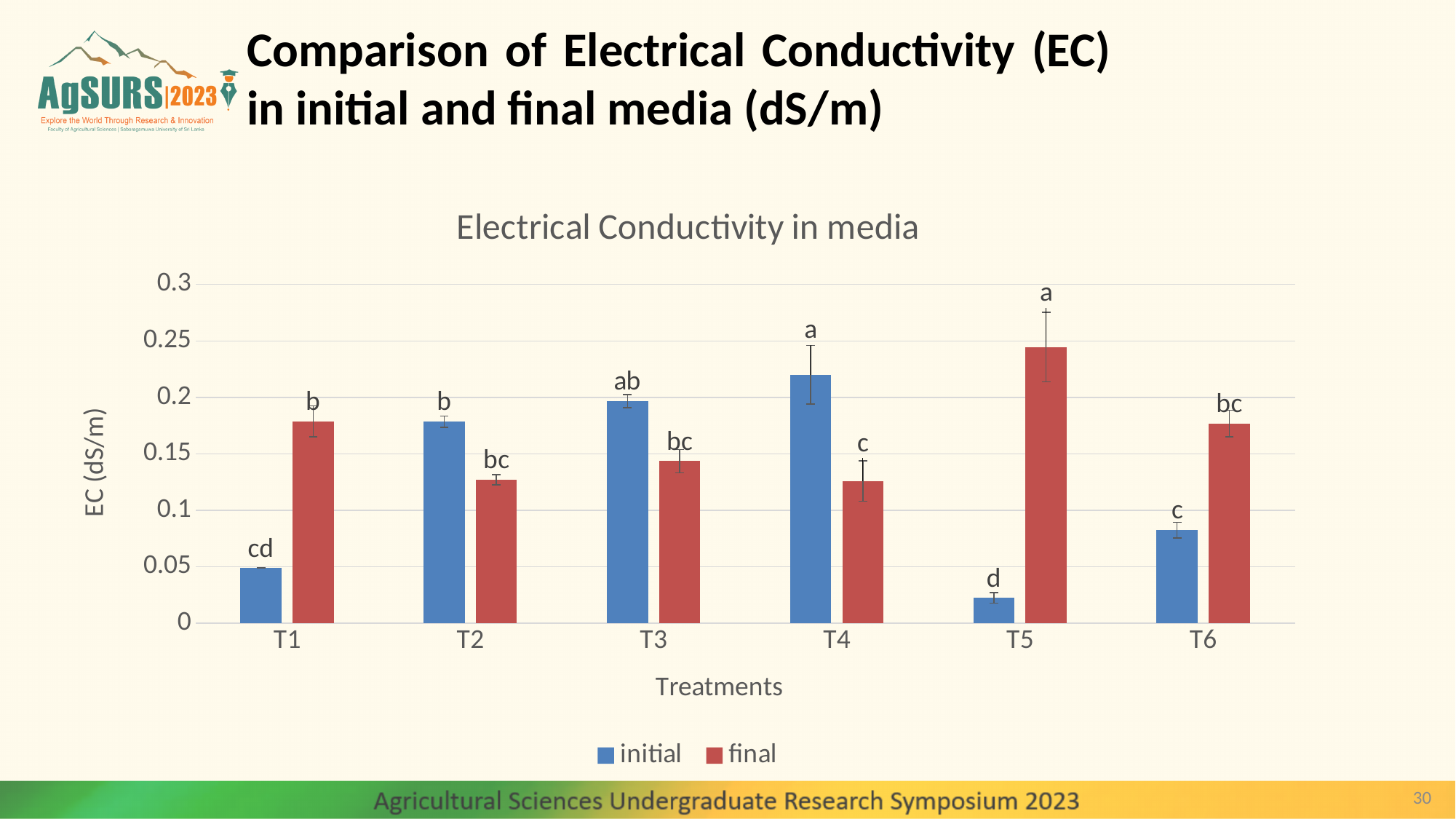
For T1, which is larger: the initial or the final EC value? final For T2, which is larger: the initial or the final EC value? initial What is the label on the y axis of the chart? EC (dS/m) How many treatments are shown on the x axis? 6 How many series does the legend list? 2 Which treatment has the highest final EC value? T5 Is the final EC value for T5 greater or less than 0.2? greater What kind of chart is shown on the slide? bar chart Which treatment has the highest initial EC value? T4 Is the initial EC value for T4 greater or less than 0.2? greater Is the initial EC value for T5 greater or less than 0.05? less Which treatment has the lowest initial EC value? T5